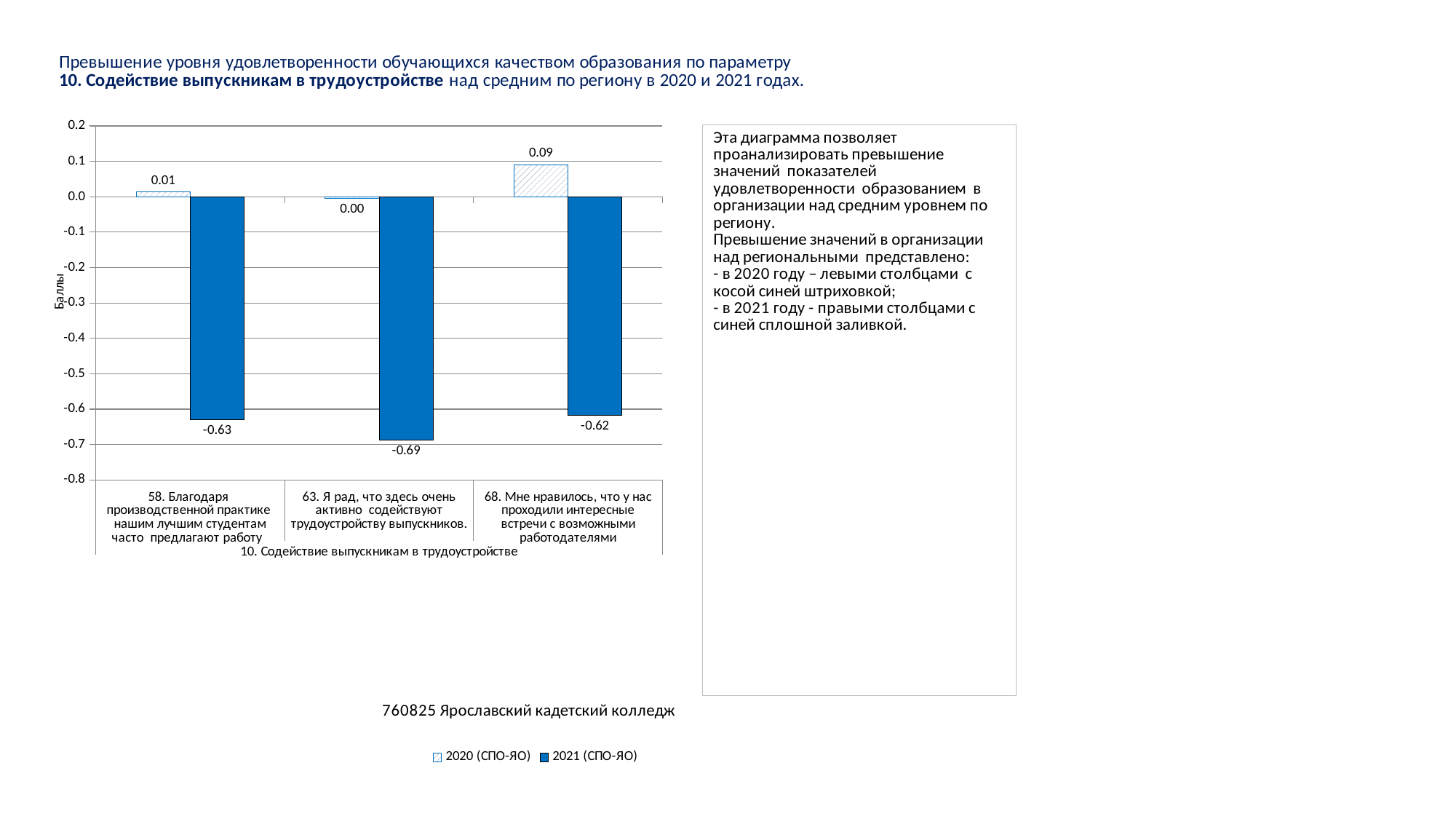
How many categories are shown on the x axis of the chart? 3 Which is larger: the 2021 value for category 58 or the 2021 value for category 68? 2021 value for category 68 (-0.62) What is the label of the y axis of the chart? Баллы Which category has the lowest 2021 (СПО-ЯО) value? 63. Я рад, что здесь очень активно содействуют трудоустройству выпускников. What is the difference between the 2020 and 2021 values for category 68? 0.71 What is the 2021 (СПО-ЯО) value for category 58? -0.63 What type of chart is shown on the slide? Bar chart What is the 2020 (СПО-ЯО) value for category 58 (Благодаря производственной практике нашим лучшим студентам часто предлагают работу)? 0.01 How many series does the legend list? 2 What is the 2021 (СПО-ЯО) value for category 63 (Я рад, что здесь очень активно содействуют трудоустройству выпускников)? -0.69 What is the 2020 (СПО-ЯО) value for category 68 (Мне нравилось, что у нас проходили интересные встречи с возможными работодателями)? 0.09 Which category has the highest 2020 (СПО-ЯО) value? 68. Мне нравилось, что у нас проходили интересные встречи с возможными работодателями